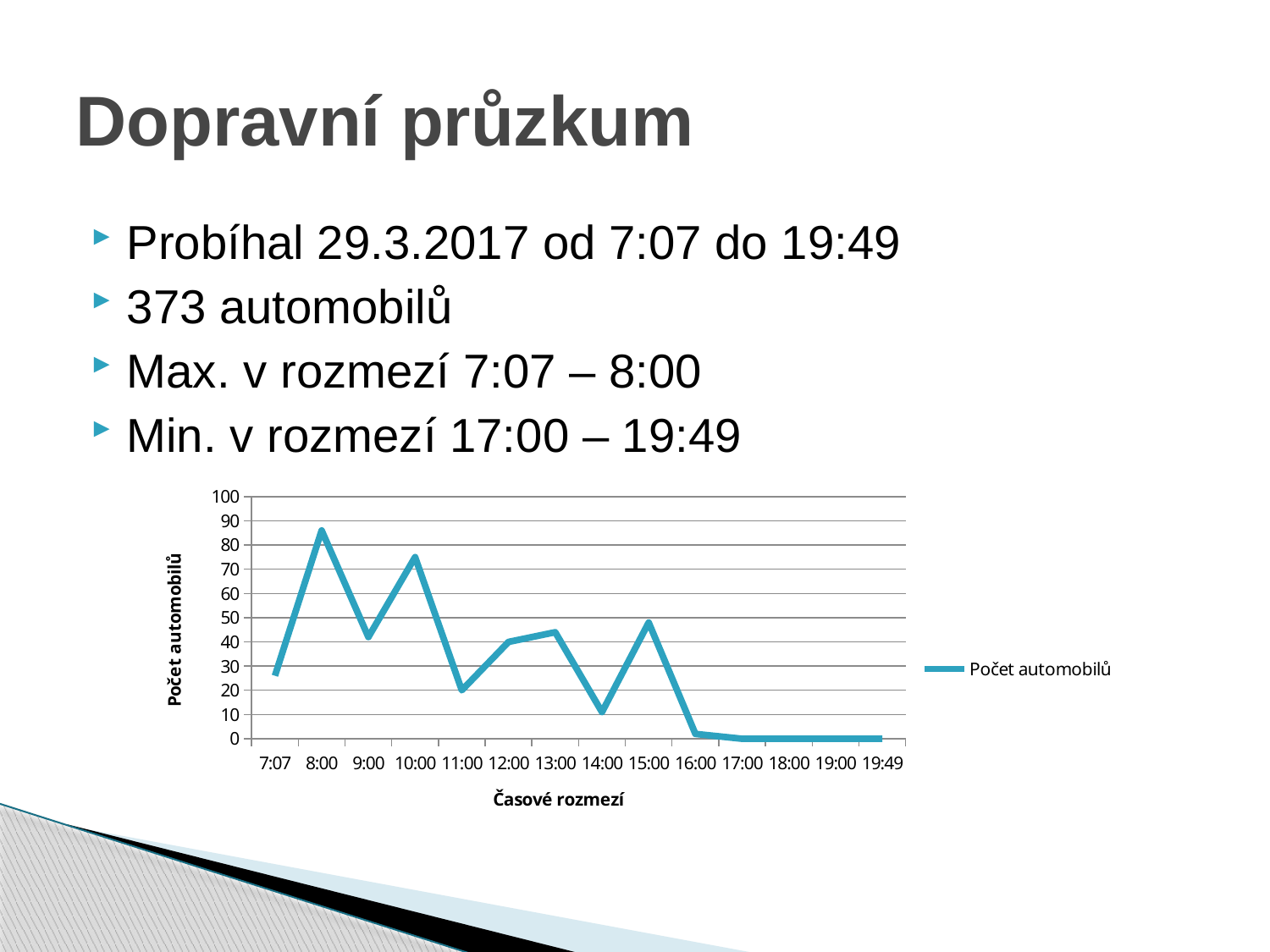
At which time is the number of cars (Počet automobilů) highest? 8:00 Is the value for 14:00 greater or less than 20? less Is the value for 11:00 greater or less than 30? less What is the title of the x axis of the chart? Časové rozmezí Is the value for 7:07 greater or less than 30? less Which has the larger value, 11:00 or 14:00? 11:00 How many series does the chart legend list? 1 What kind of chart is shown on the slide? line chart How many time points are plotted along the x axis of the chart? 14 Which has the larger value, 8:00 or 10:00? 8:00